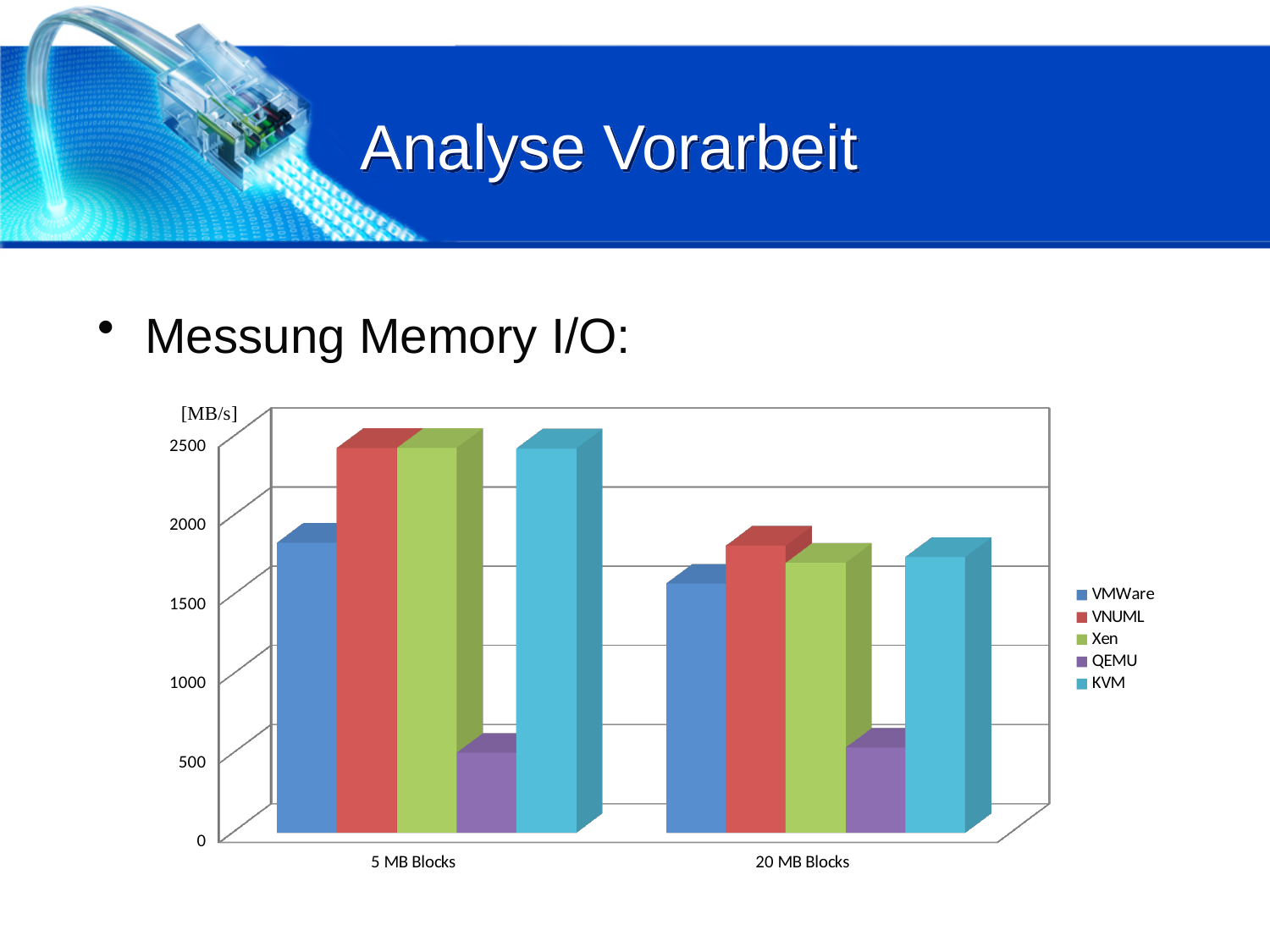
What unit is shown on the y axis of the chart? [MB/s] Which series has the lowest value for 5 MB Blocks? QEMU Is the value for VNUML at 5 MB Blocks greater or less than 2000? greater Is the value for KVM at 20 MB Blocks greater or less than 2000? less Is the value for VMWare at 20 MB Blocks greater or less than 1000? greater Which series has the lowest value for 20 MB Blocks? QEMU How many categories are shown on the x axis? 2 Does the value for KVM rise or fall from 5 MB Blocks to 20 MB Blocks? fall What kind of chart is shown on the slide? bar chart How many series does the legend list? 5 Which is larger for 5 MB Blocks, VMWare or QEMU? VMWare